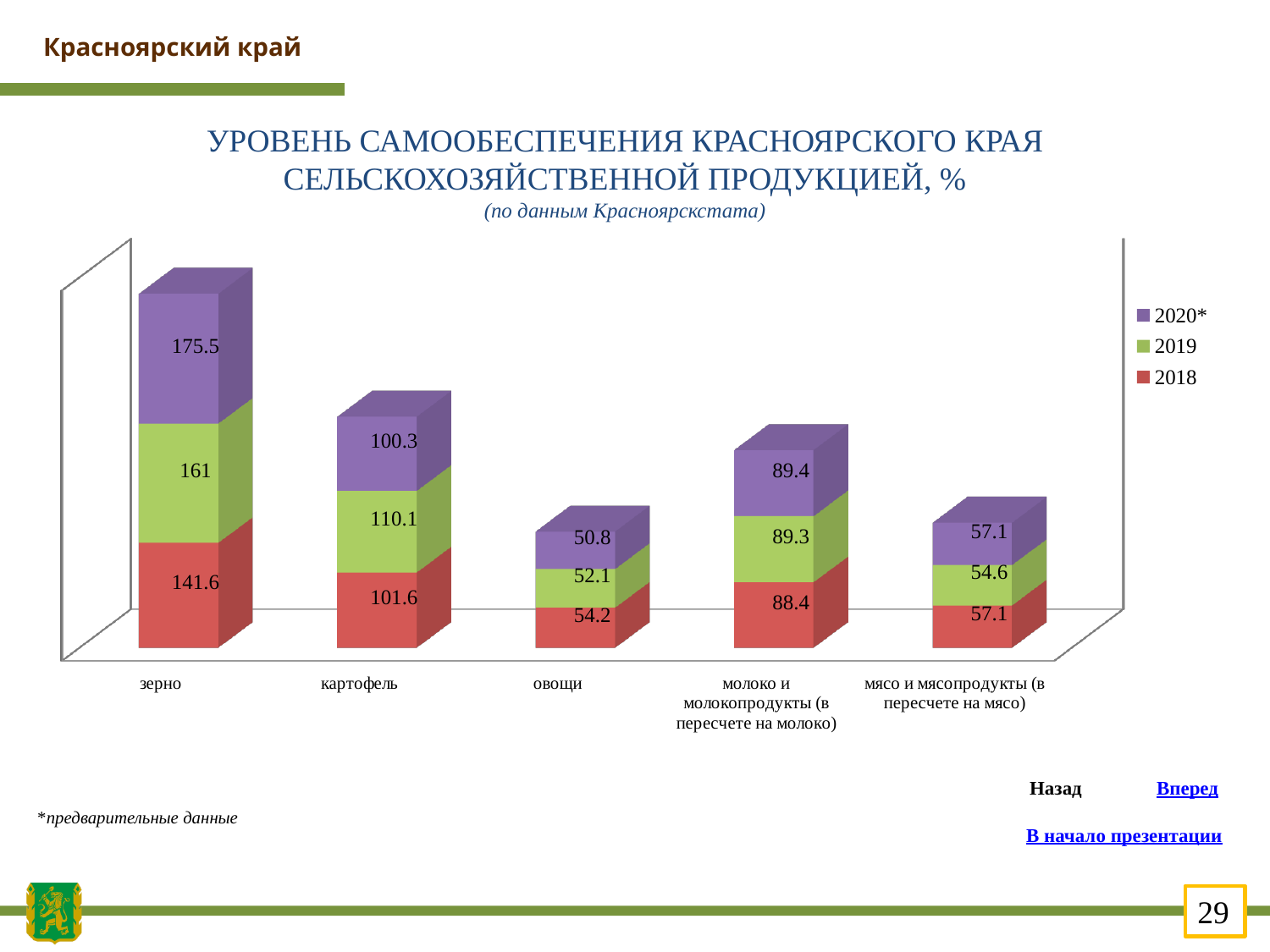
What is the 2019 value for овощи? 52.1 What is the difference between the 2020* and 2018 values for зерно? 33.9 How many series does the legend list? 3 Which category has the highest 2020* value? зерно What is the 2019 value for мясо и мясопродукты (в пересчете на мясо)? 54.6 What is the 2020* value for молоко и молокопродукты (в пересчете на молоко)? 89.4 What is the 2018 value for картофель? 101.6 Which category has the lowest 2018 value? овощи What is the 2020* value for зерно? 175.5 How many categories are shown on the x axis? 5 What kind of chart is shown on the slide? stacked bar chart Which is larger for картофель: the 2019 value or the 2020* value? 2019